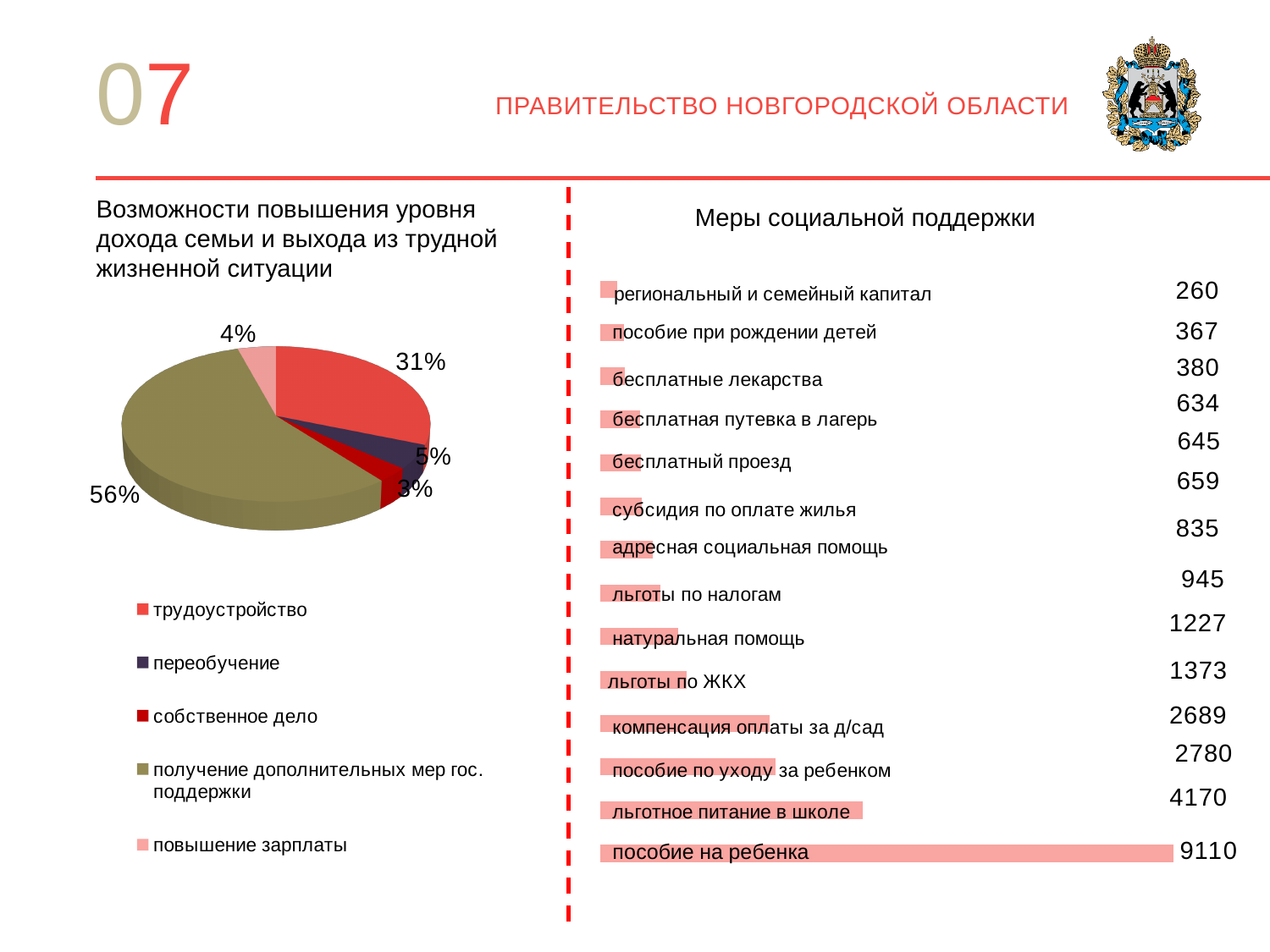
On the chart 'Меры социальной поддержки', which category has the lowest value? региональный и семейный капитал On the chart 'Меры социальной поддержки', what is the value for 'пособие на ребенка'? 9110 On the pie chart on the left, which category has the largest share? получение дополнительных мер гос. поддержки On the chart 'Меры социальной поддержки', how many categories are shown? 14 On the pie chart on the left, what is the difference in percentage points between 'получение дополнительных мер гос. поддержки' and 'трудоустройство'? 25 On the pie chart on the left, how many categories does the legend list? 5 On the pie chart on the left, which category has the smallest share? собственное дело What kind of chart is 'Меры социальной поддержки'? bar chart On the pie chart 'Возможности повышения уровня дохода семьи и выхода из трудной жизненной ситуации', what share does 'трудоустройство' have? 31% On the chart 'Меры социальной поддержки', what is the value for 'льготное питание в школе'? 4170 On the chart 'Меры социальной поддержки', which is larger: 'компенсация оплаты за д/сад' or 'льготы по ЖКХ'? компенсация оплаты за д/сад On the pie chart on the left, what is the share for 'переобучение'? 5%